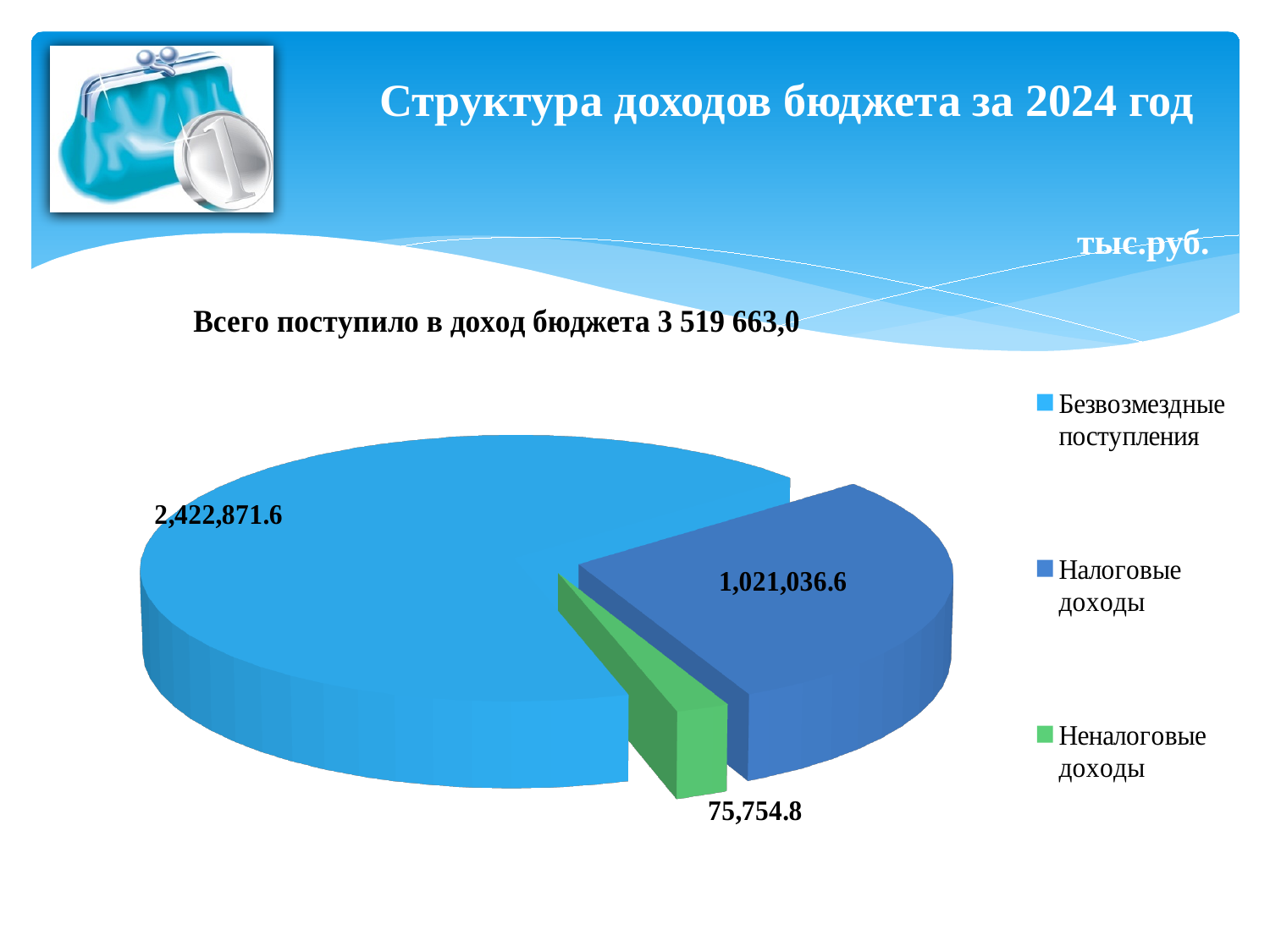
Which category has the smallest slice of the pie? Неналоговые доходы What is the value for Безвозмездные поступления? 2,422,871.6 Which is larger, Налоговые доходы or Неналоговые доходы? Налоговые доходы Which category has the largest slice of the pie? Безвозмездные поступления What is the difference between Налоговые доходы and Неналоговые доходы? 945,281.8 What kind of chart is shown on the slide? Pie chart What is the difference between Безвозмездные поступления and Налоговые доходы? 1,401,835.0 What is the title of the slide containing the chart? Структура доходов бюджета за 2024 год How many slices does the pie chart have? 3 What is the value for Налоговые доходы? 1,021,036.6 What is the value for Неналоговые доходы? 75,754.8 What is the total of all three slices of the pie? 3,519,663.0